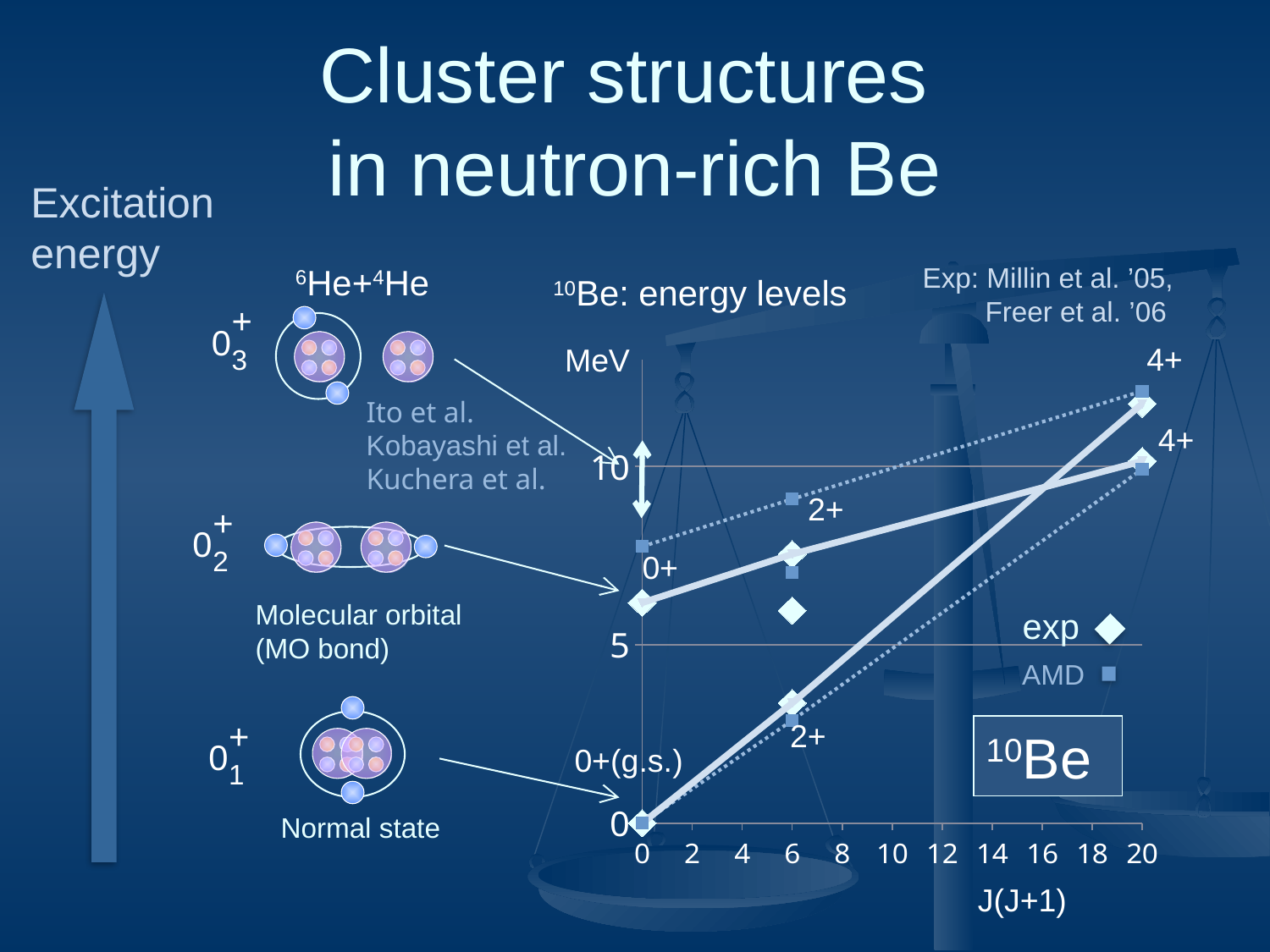
In the "10Be: energy levels" chart, is the exp value for the upper 2+ state at J(J+1)=6 greater or less than 10? less What kind of chart is the "10Be: energy levels" chart? scatter chart with lines What are the two series named in the legend of the "10Be: energy levels" chart? exp and AMD In the "10Be: energy levels" chart, is the exp value for the lowest 2+ state (at J(J+1)=6) greater or less than 5? less In the "10Be: energy levels" chart, which is larger: the exp value of the 4+ state at the top of the chart or the exp value of the 0+(g.s.) state? the 4+ state In the "10Be: energy levels" chart, is the exp value for the excited 0+ state at J(J+1)=0 greater or less than 5? greater What is the energy value of the 0+(g.s.) state in the "10Be: energy levels" chart? 0 What is the label of the x axis of the "10Be: energy levels" chart? J(J+1) In the "10Be: energy levels" chart, do the energy values rise or fall as J(J+1) increases along the x axis? rise How many series does the legend of the "10Be: energy levels" chart list? 2 What is the largest value shown on the x axis of the "10Be: energy levels" chart? 20